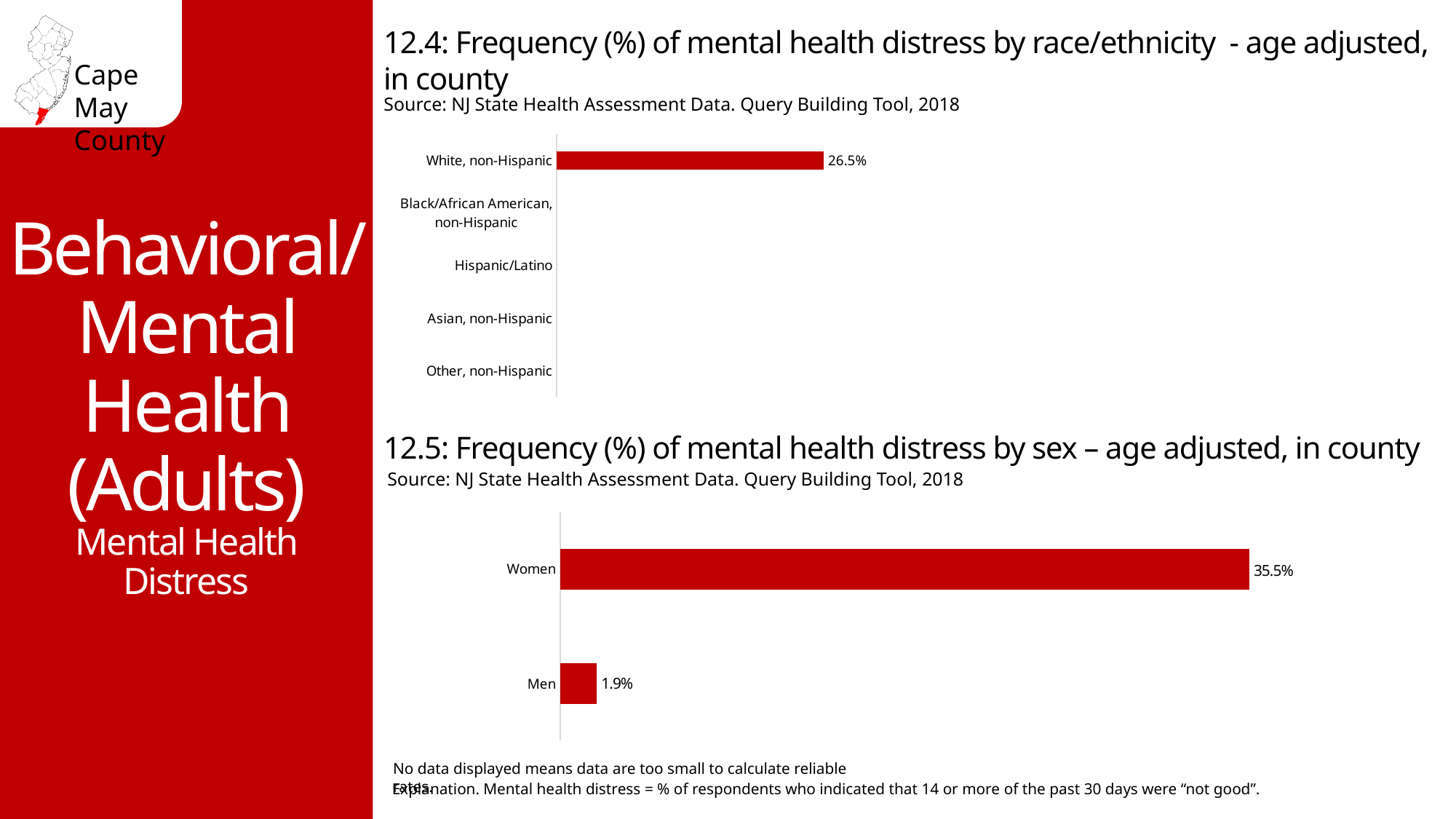
In the chart 12.5 (mental health distress by sex), which category has the higher value? Women In the chart 12.5 (mental health distress by sex), what is the value for Men? 1.9% In the chart 12.4 (mental health distress by race/ethnicity), what is the value for White, non-Hispanic? 26.5% In the chart 12.5 (mental health distress by sex), what is the difference between the values for Women and Men? 33.6% In the chart 12.5 (mental health distress by sex), what is the value for Women? 35.5% In the chart 12.5 (mental health distress by sex), which category has the lowest value? Men In the chart 12.4 (mental health distress by race/ethnicity), which category is the only one with a bar displayed? White, non-Hispanic What is the source cited for both charts on the slide? NJ State Health Assessment Data. Query Building Tool, 2018 What kind of chart is chart 12.4 (mental health distress by race/ethnicity)? Bar chart In the chart 12.4 (mental health distress by race/ethnicity), how many race/ethnicity categories are listed on the axis? 5 What kind of chart is chart 12.5 (mental health distress by sex)? Bar chart In the chart 12.5 (mental health distress by sex), how many categories are shown? 2